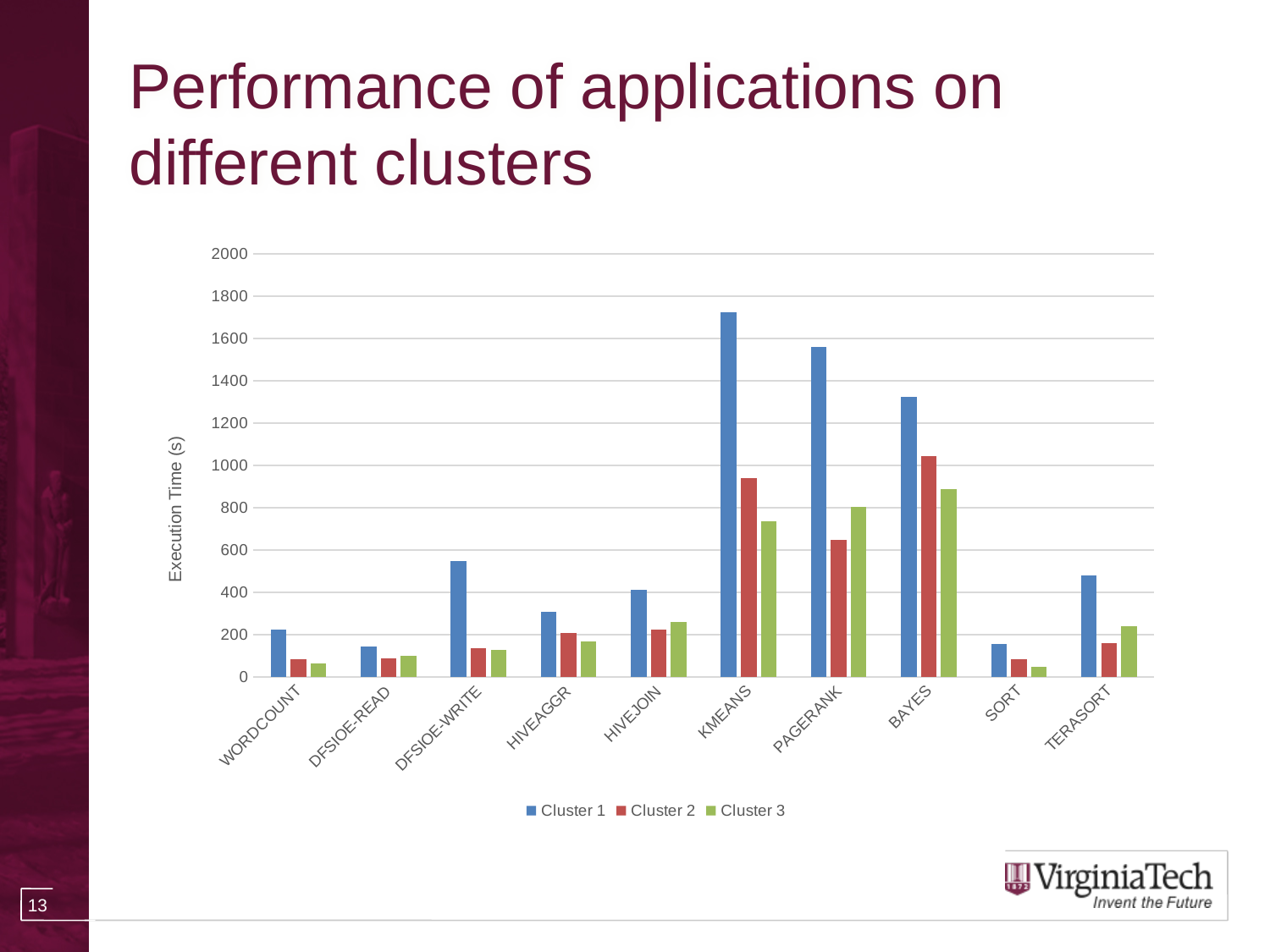
Which has the larger Cluster 1 execution time, BAYES or KMEANS? KMEANS How many applications are shown along the x axis? 10 Which application has the highest execution time for Cluster 1? KMEANS Is the Cluster 1 execution time for KMEANS greater or less than 1600? greater How many series does the legend list? 3 What is the label on the y axis of the chart? Execution Time (s) For PAGERANK, which has the larger execution time, Cluster 2 or Cluster 3? Cluster 3 What kind of chart is shown on the slide? bar chart Is the Cluster 2 execution time for PAGERANK greater or less than 800? less For BAYES, which cluster has the highest execution time? Cluster 1 Which application has the lowest execution time for Cluster 3? SORT Is the Cluster 1 execution time for DFSIOE-WRITE greater or less than 400? greater